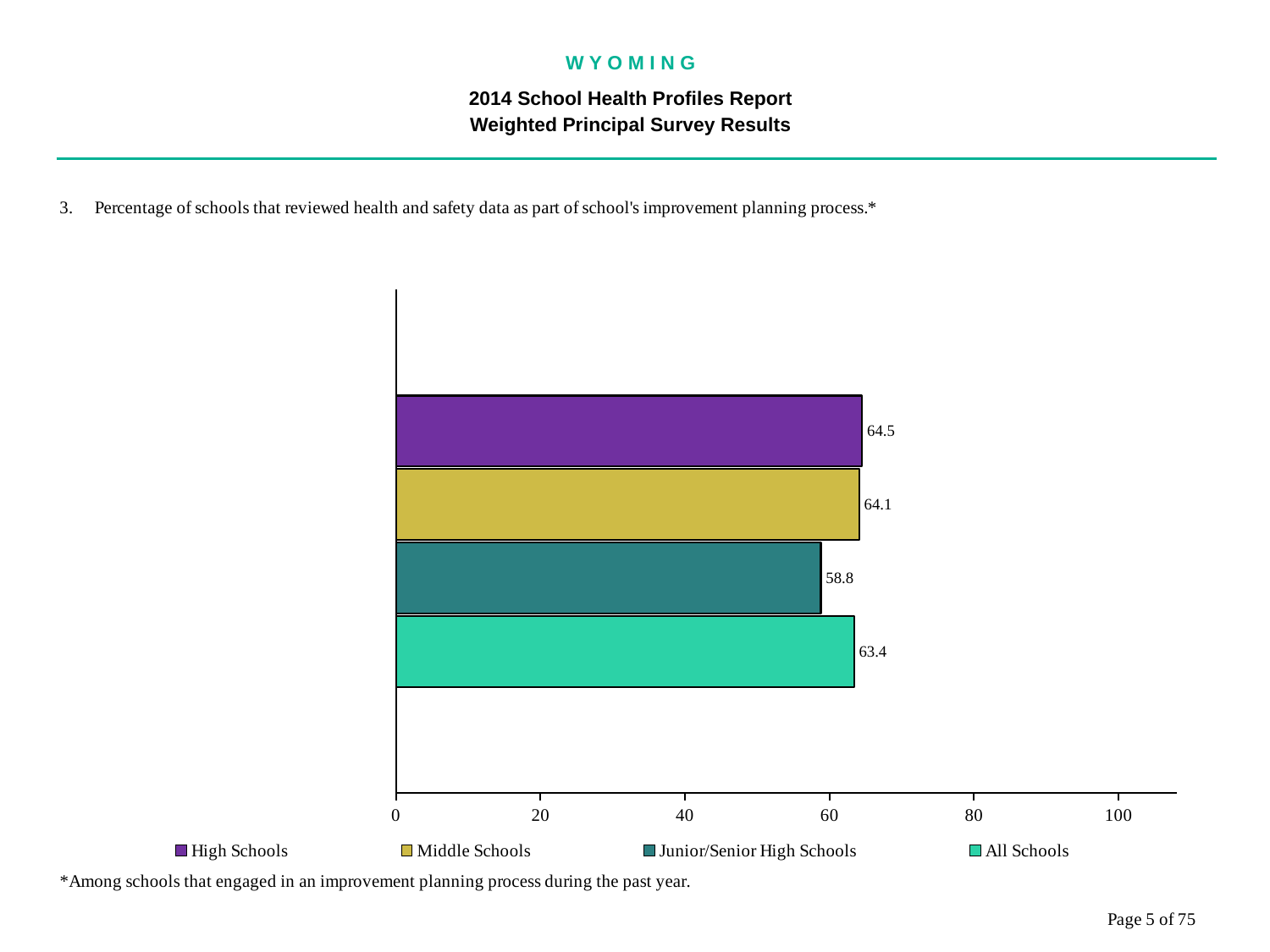
Which school type has the lowest value? Junior/Senior High Schools How many entries does the legend list? 4 What is the difference between the values for Middle Schools and All Schools? 0.7 What is the value for Middle Schools? 64.1 How many bars are shown in the chart? 4 What is the difference between the values for High Schools and Junior/Senior High Schools? 5.7 Is the value for Junior/Senior High Schools greater or less than 60? less Which is larger, the value for Middle Schools or the value for Junior/Senior High Schools? Middle Schools What is the value for All Schools? 63.4 What is the value for High Schools? 64.5 What kind of chart is shown on the slide? bar chart What is the value for Junior/Senior High Schools? 58.8